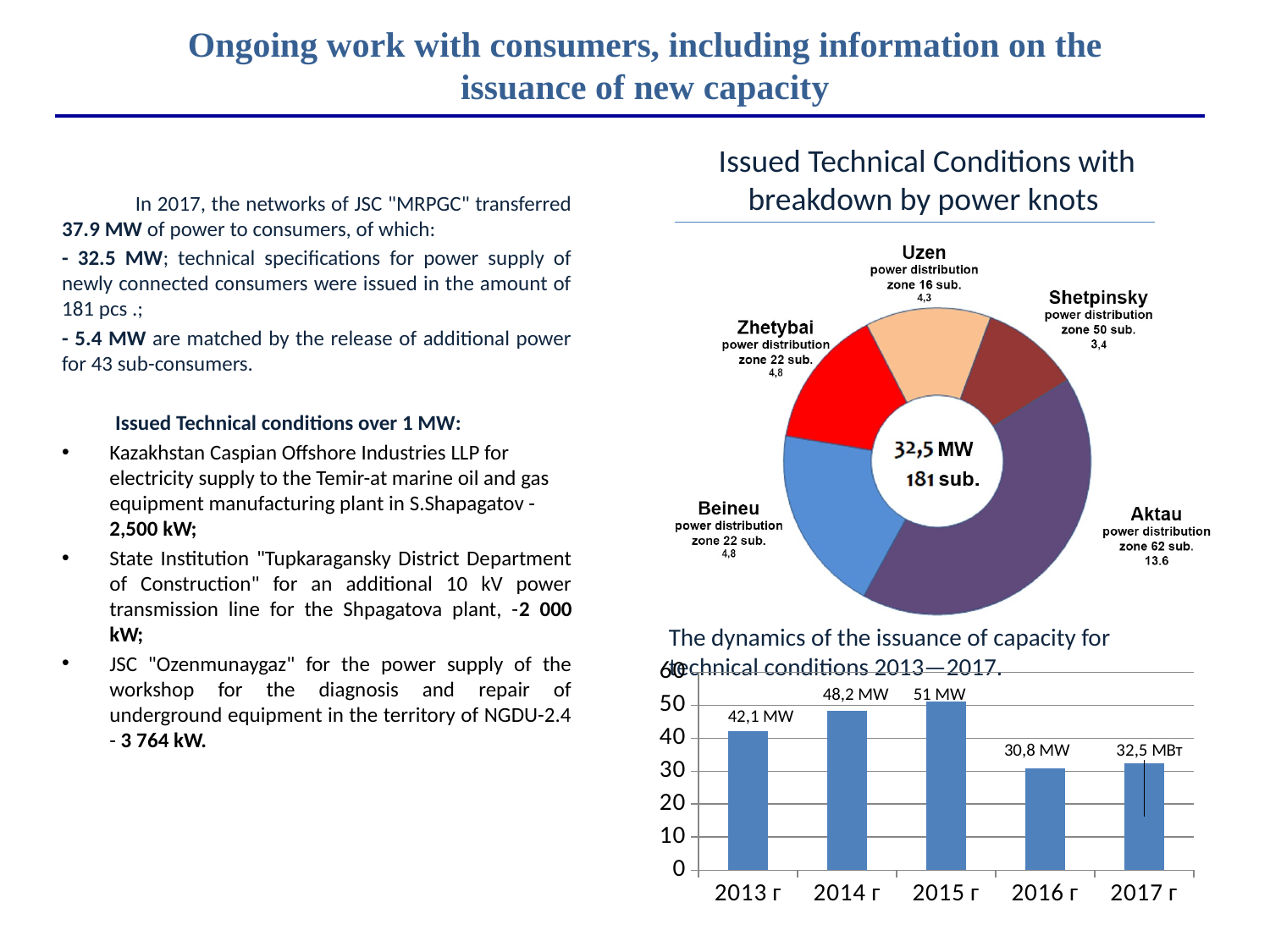
In the bar chart 'The dynamics of the issuance of capacity for technical conditions 2013—2017', how many years are shown on the x axis? 5 In the bar chart 'The dynamics of the issuance of capacity for technical conditions 2013—2017', which is larger, the value for 2016 г or 2017 г? 2017 г In the donut chart 'Issued Technical Conditions with breakdown by power knots', which power distribution zone has the largest slice? Aktau In the bar chart 'The dynamics of the issuance of capacity for technical conditions 2013—2017', which year has the highest value? 2015 г In the bar chart 'The dynamics of the issuance of capacity for technical conditions 2013—2017', which year has the lowest value? 2016 г In the donut chart 'Issued Technical Conditions with breakdown by power knots', how many power distribution zones are shown? 5 In the bar chart 'The dynamics of the issuance of capacity for technical conditions 2013—2017', what is the value for 2015 г? 51 MW In the bar chart 'The dynamics of the issuance of capacity for technical conditions 2013—2017', what is the value for 2013 г? 42,1 MW In the donut chart 'Issued Technical Conditions with breakdown by power knots', what is the value for the Aktau power distribution zone? 13.6 What kind of chart is 'The dynamics of the issuance of capacity for technical conditions 2013—2017'? bar chart In the bar chart 'The dynamics of the issuance of capacity for technical conditions 2013—2017', what is the difference between the values for 2014 г and 2013 г? 6,1 MW In the donut chart 'Issued Technical Conditions with breakdown by power knots', how many sub. are listed for the Shetpinsky power distribution zone? 50 sub.